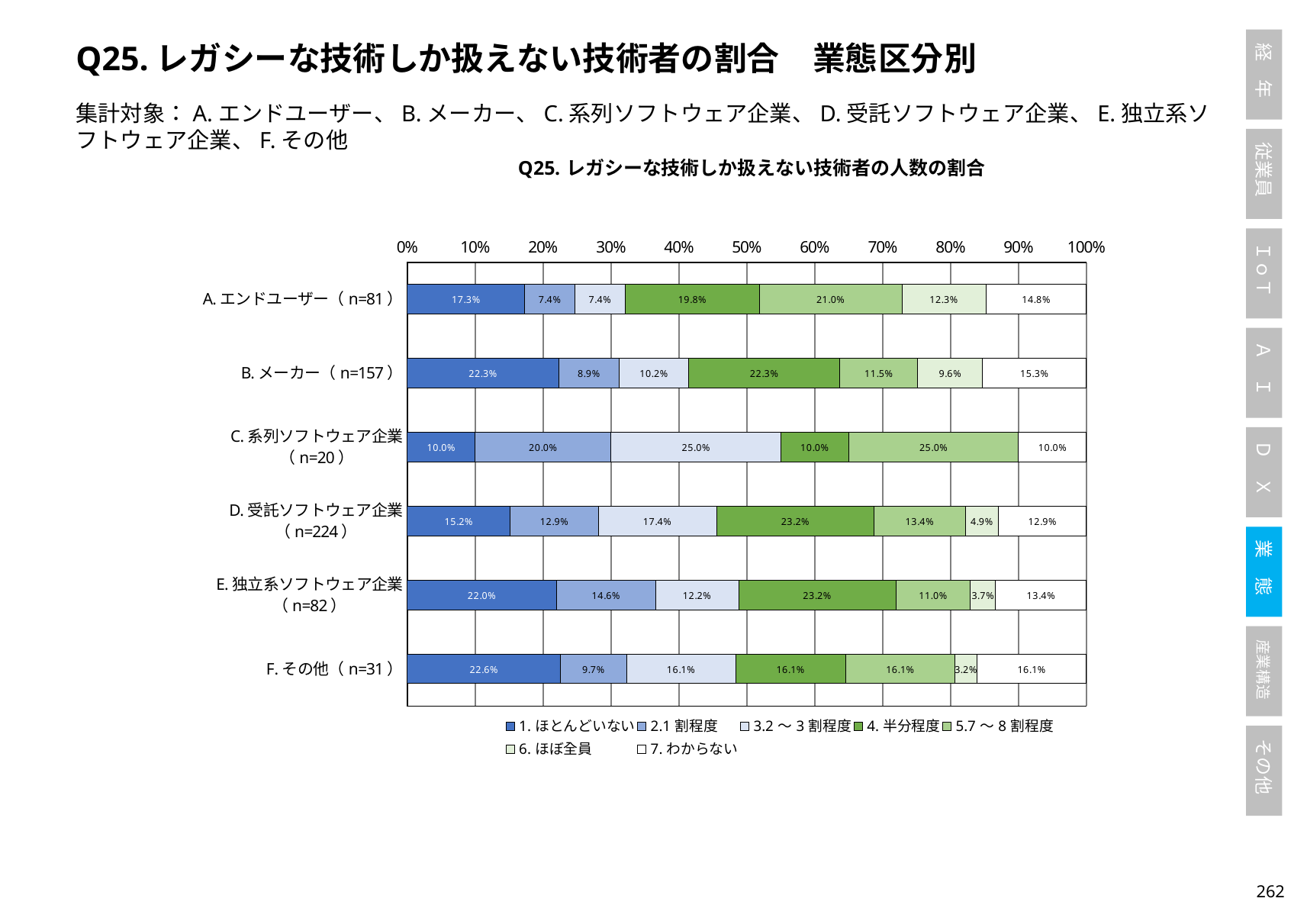
In the E. 独立系ソフトウェア企業 bar, which is larger: "4. 半分程度" or "2. 1割程度"? 4. 半分程度 In the B. メーカー bar, what is the difference between "1. ほとんどいない" and "2. 1割程度"? 13.4 percentage points What is the value for "3. 2～3割程度" in the C. 系列ソフトウェア企業 bar? 25.0% What kind of chart is shown on the slide? Stacked bar chart Which category has the lowest value for "7. わからない"? C. 系列ソフトウェア企業 How many categories (bars) are shown in the chart? 6 What is the value for "1. ほとんどいない" in the A. エンドユーザー bar? 17.3% Which category has the highest value for "6. ほぼ全員"? A. エンドユーザー What is the sample size (n) shown for D. 受託ソフトウェア企業? 224 What is the value for "7. わからない" in the F. その他 bar? 16.1% What is the value for "4. 半分程度" in the D. 受託ソフトウェア企業 bar? 23.2% How many series does the legend list? 7